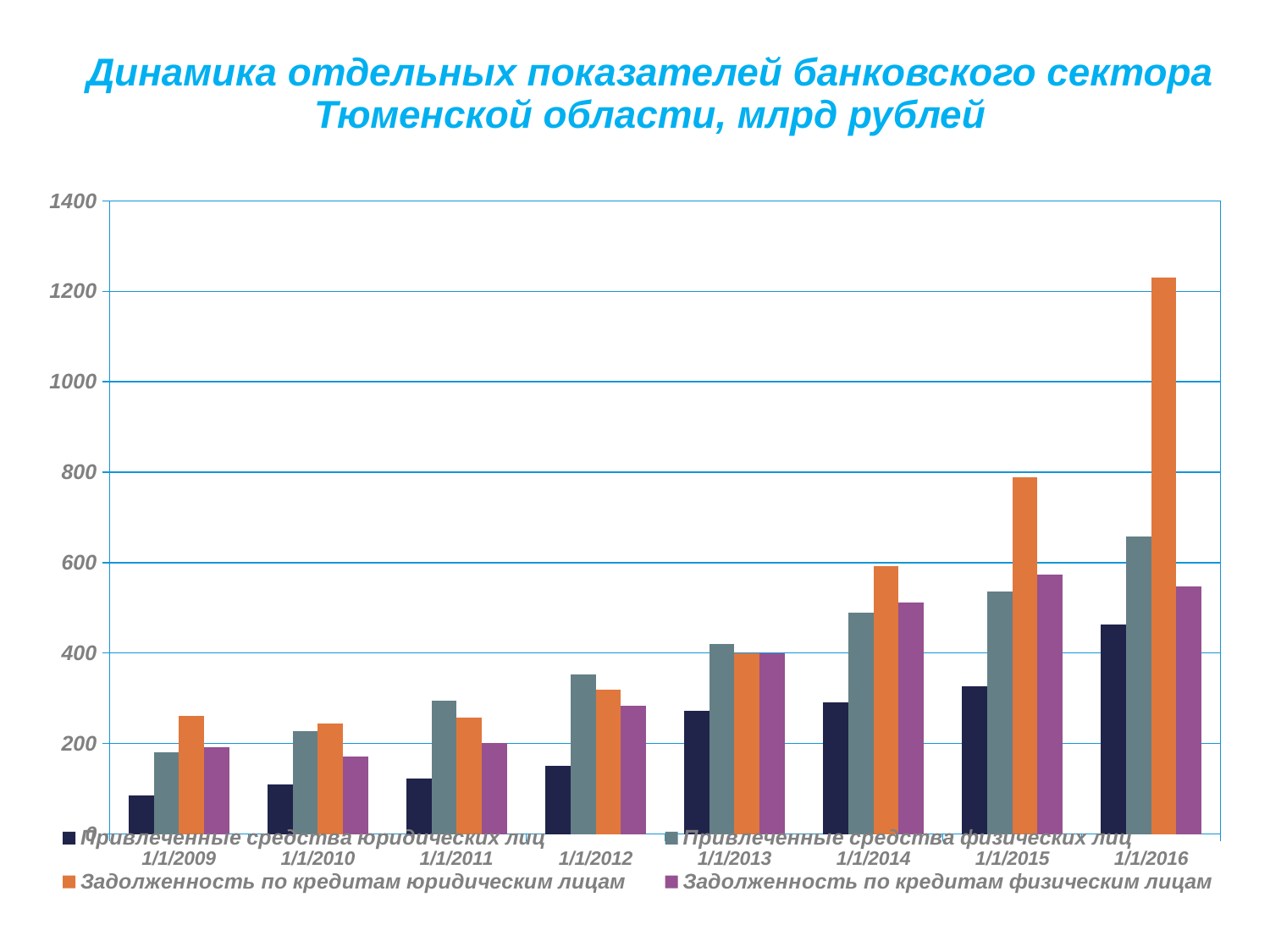
At which date is Привлеченные средства юридических лиц lowest? 1/1/2009 What kind of chart is shown on the slide? bar chart Is the value for Задолженность по кредитам юридическим лицам at 1/1/2016 greater or less than 1200? greater How many series does the legend list? 4 Do the values for Привлеченные средства юридических лиц rise or fall from 1/1/2009 to 1/1/2016? rise How many dates (categories) are shown along the x axis? 8 At which date does Задолженность по кредитам юридическим лицам reach its highest value? 1/1/2016 Is the value for Привлеченные средства юридических лиц at 1/1/2016 greater or less than 400? greater Is the value for Задолженность по кредитам физическим лицам at 1/1/2015 greater or less than 400? greater At 1/1/2016, which is larger: Задолженность по кредитам юридическим лицам or Привлеченные средства физических лиц? Задолженность по кредитам юридическим лицам